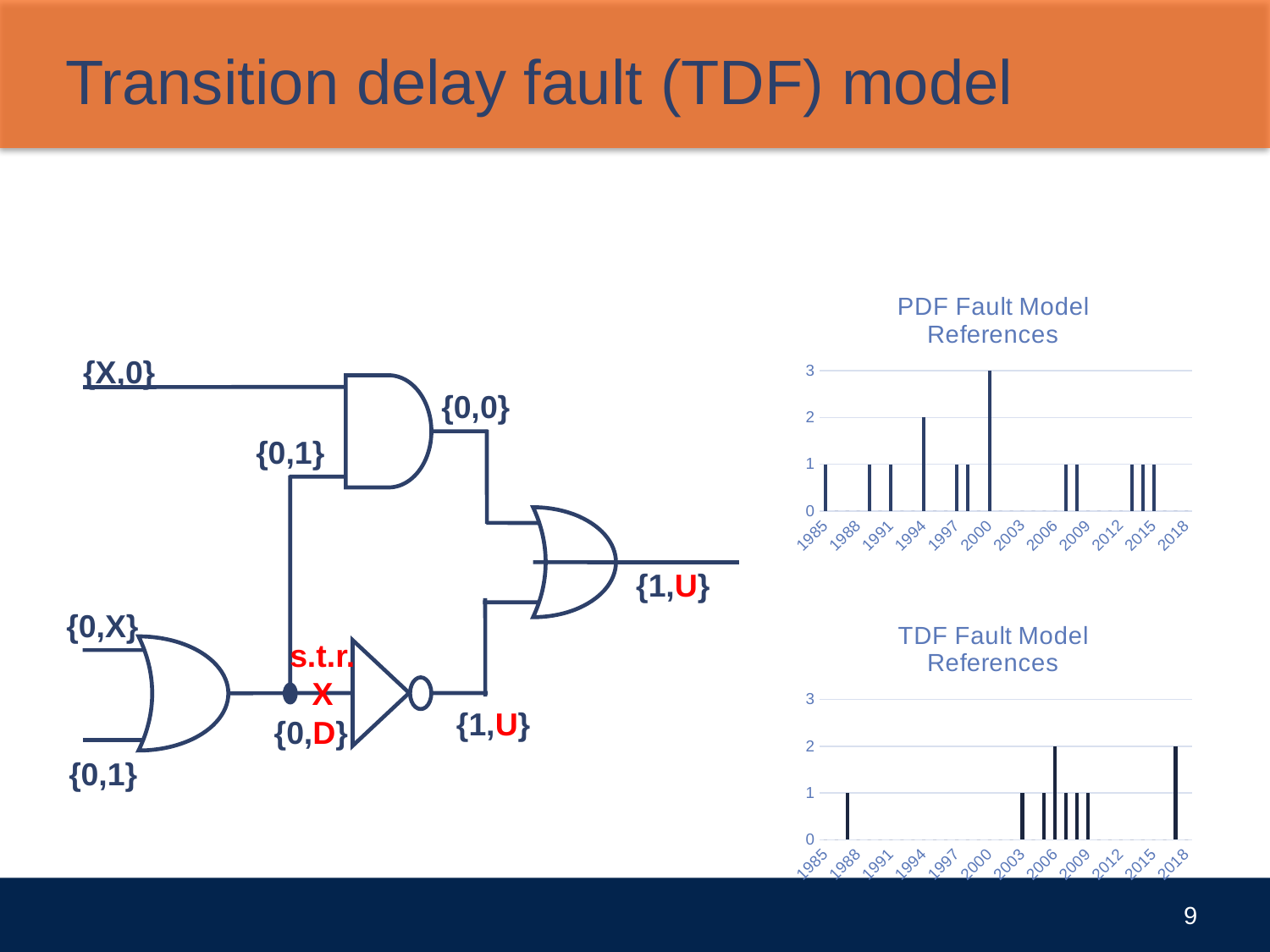
In the 'PDF Fault Model References' chart, what is the value for the year 1985? 1 What is the title of the lower chart on the slide? TDF Fault Model References In the 'TDF Fault Model References' chart, what is the highest value reached by any bar? 2 In the 'TDF Fault Model References' chart, what is the value for the year 2006? 2 Which is larger: the value for 2000 in the 'PDF Fault Model References' chart or the value for 2018 in the 'TDF Fault Model References' chart? 2000 in the PDF Fault Model References chart What kind of chart is the 'PDF Fault Model References' chart? bar chart In the 'PDF Fault Model References' chart, what is the value for the year 1994? 2 In the 'PDF Fault Model References' chart, which year has the highest number of references? 2000 In the 'PDF Fault Model References' chart, what is the difference between the values for 2000 and 1994? 1 In the 'TDF Fault Model References' chart, is the value for 1988 greater or less than 2? less In the 'PDF Fault Model References' chart, what is the value for the year 2000? 3